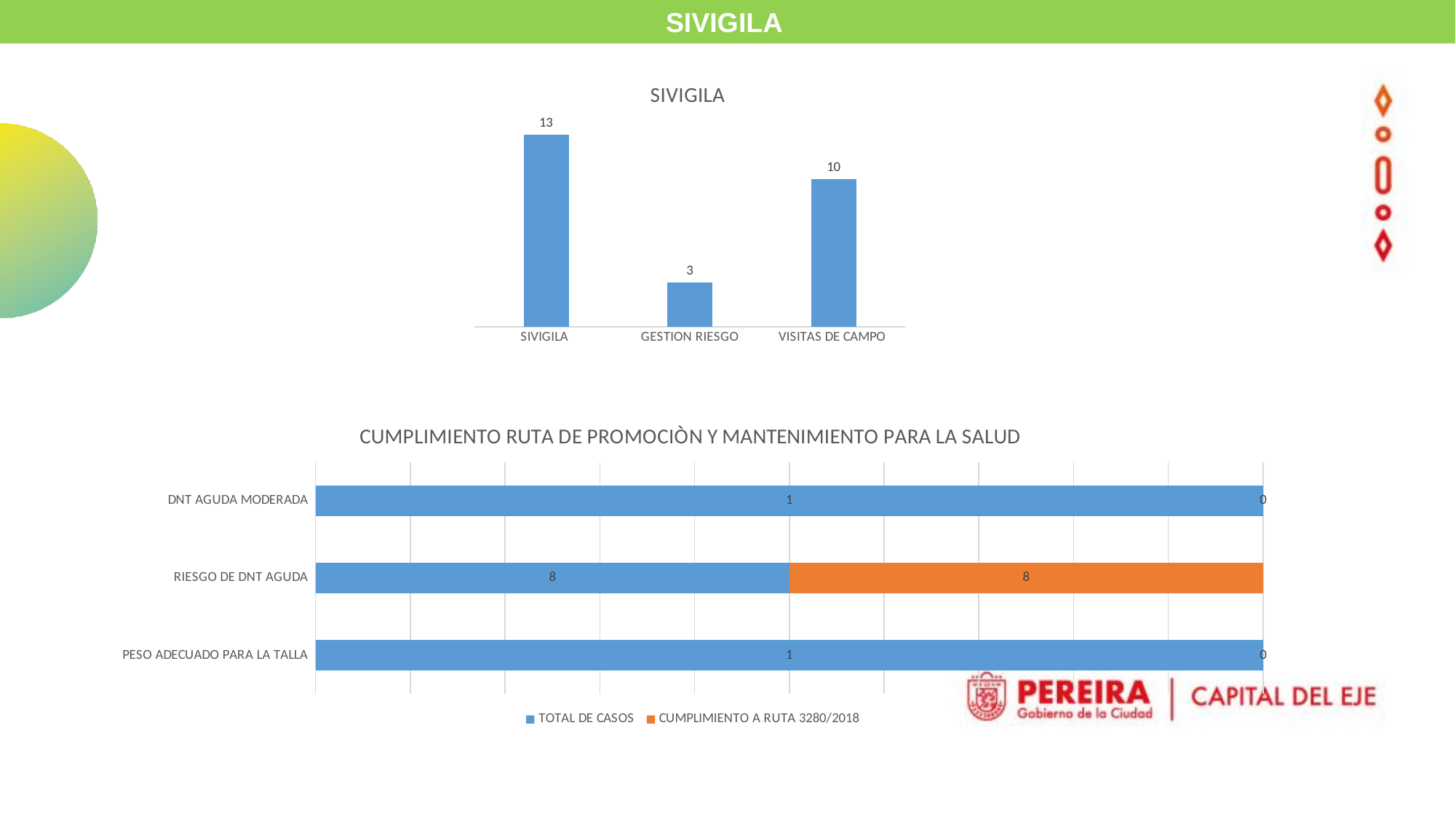
In the CUMPLIMIENTO RUTA DE PROMOCIÒN Y MANTENIMIENTO PARA LA SALUD chart, which colour represents CUMPLIMIENTO A RUTA 3280/2018? Orange In the SIVIGILA chart, what is the value for GESTION RIESGO? 3 What kind of chart is the SIVIGILA chart? Bar chart In the SIVIGILA chart, what is the value for VISITAS DE CAMPO? 10 In the SIVIGILA chart, how many categories are shown? 3 In the CUMPLIMIENTO RUTA DE PROMOCIÒN Y MANTENIMIENTO PARA LA SALUD chart, how many series does the legend list? 2 In the SIVIGILA chart, which category has the lowest value? GESTION RIESGO In the CUMPLIMIENTO RUTA DE PROMOCIÒN Y MANTENIMIENTO PARA LA SALUD chart, which category has the highest TOTAL DE CASOS value? RIESGO DE DNT AGUDA In the SIVIGILA chart, what is the difference between the values for SIVIGILA and VISITAS DE CAMPO? 3 In the CUMPLIMIENTO RUTA DE PROMOCIÒN Y MANTENIMIENTO PARA LA SALUD chart, what is the TOTAL DE CASOS value for RIESGO DE DNT AGUDA? 8 In the CUMPLIMIENTO RUTA DE PROMOCIÒN Y MANTENIMIENTO PARA LA SALUD chart, what is the CUMPLIMIENTO A RUTA 3280/2018 value for DNT AGUDA MODERADA? 0 In the SIVIGILA chart, which category has the highest value? SIVIGILA